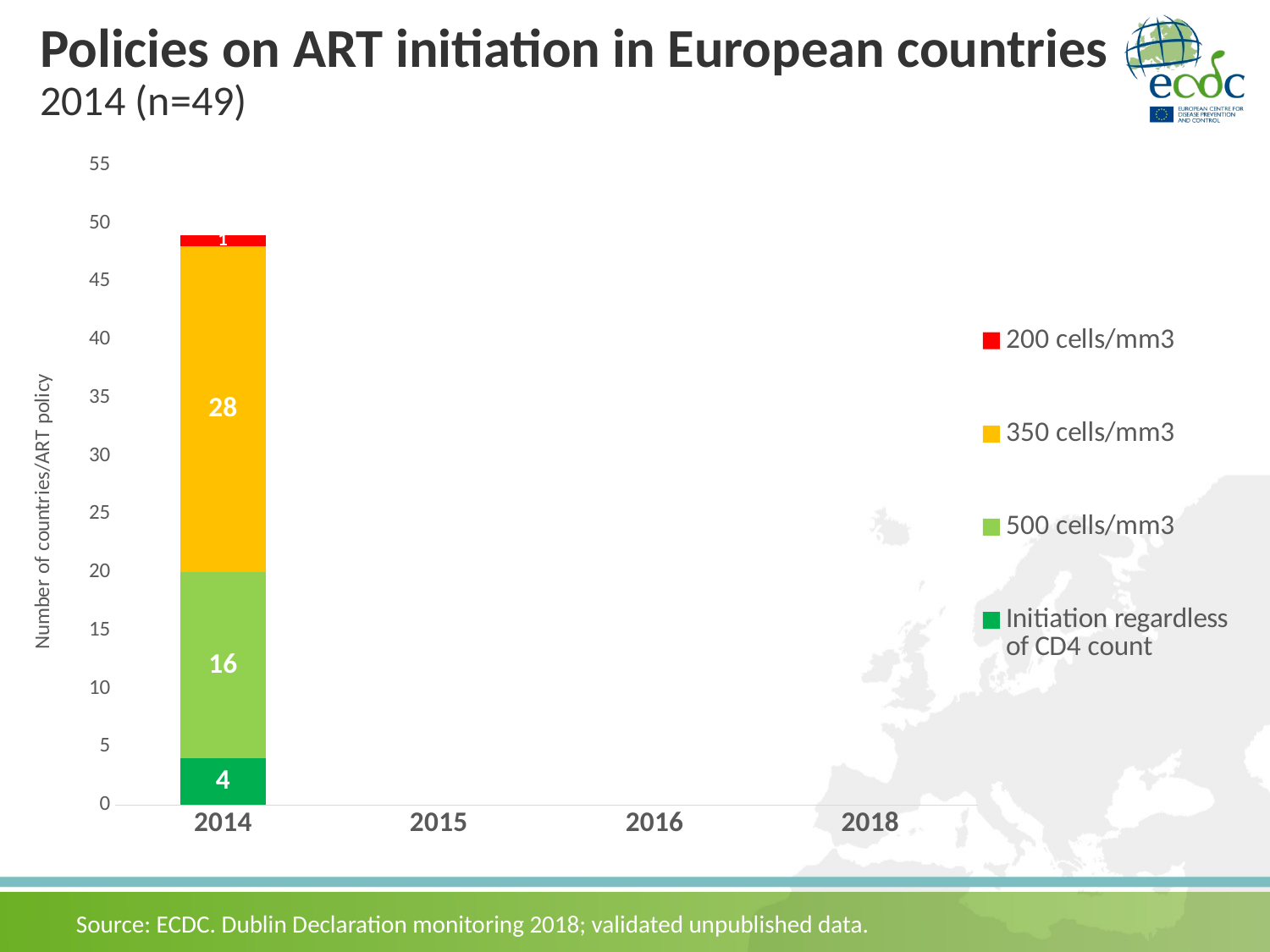
How many countries had a policy of initiation regardless of CD4 count in 2014? 4 How many countries had a 200 cells/mm3 ART initiation policy in 2014? 1 What is the total number of countries in the 2014 stacked bar? 49 How many countries had a 500 cells/mm3 ART initiation policy in 2014? 16 What is the difference between the number of countries with a 350 cells/mm3 policy and those with a 500 cells/mm3 policy in 2014? 12 How many countries had a 350 cells/mm3 ART initiation policy in 2014? 28 How many series does the legend list? 4 Which ART policy category had the most countries in 2014? 350 cells/mm3 What kind of chart is shown on the slide? Stacked bar chart Which ART policy category had the fewest countries in 2014? 200 cells/mm3 What is the label of the y axis? Number of countries/ART policy In 2014, which had more countries: the 500 cells/mm3 policy or initiation regardless of CD4 count? 500 cells/mm3